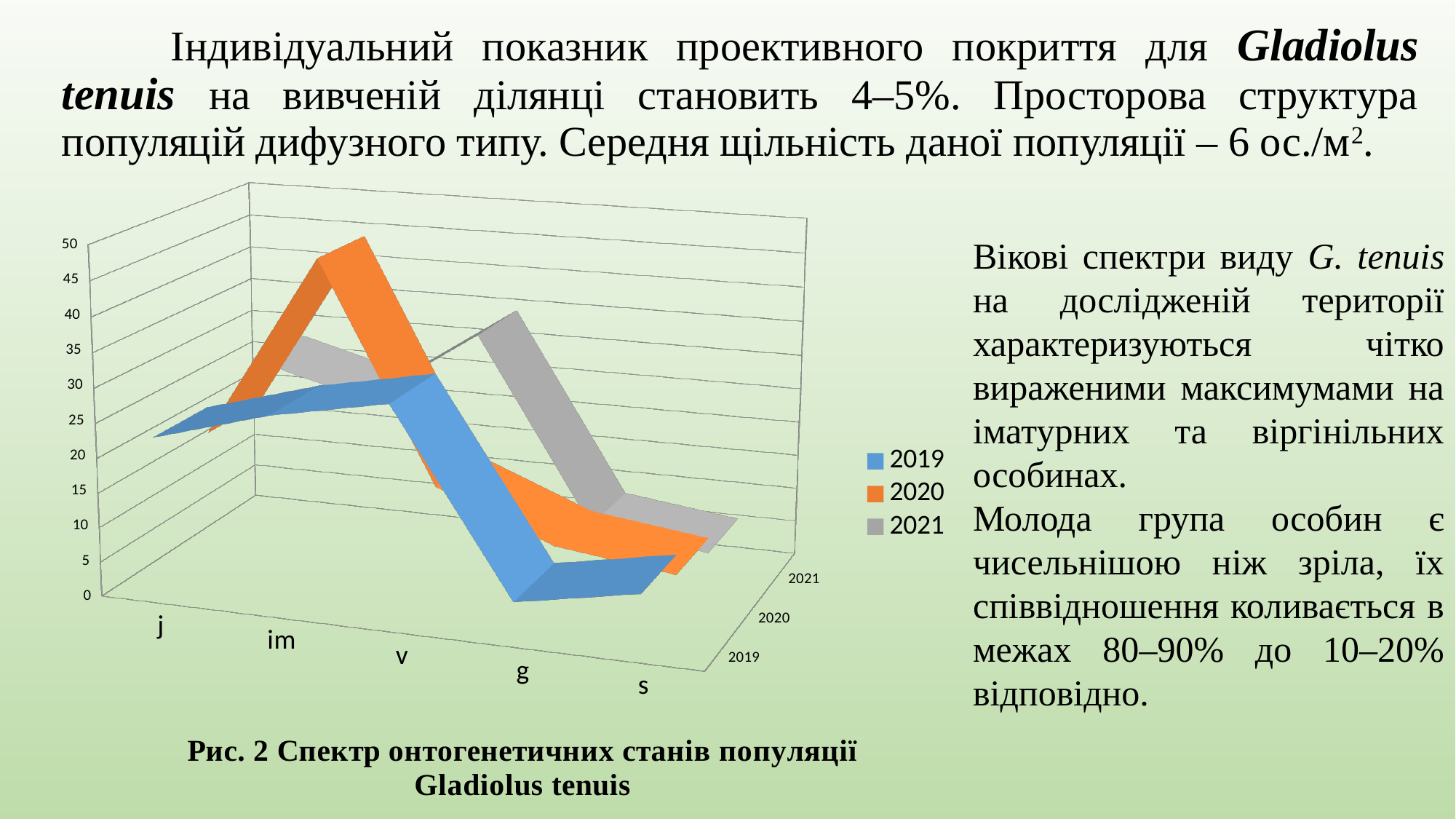
For the 2019 series, which category has the lowest value? g How many series does the chart legend list? 3 Is the value for 2020 at im greater or less than 30? greater At category im, which series has the larger value, 2019 or 2020? 2020 Do the values for the 2019 series rise or fall from v to g? fall Is the value for 2019 at g greater or less than 10? less What is the figure caption below the chart? Рис. 2 Спектр онтогенетичних станів популяції Gladiolus tenuis For the 2019 series, which category has the highest value? v Which years are listed in the chart legend? 2019, 2020, 2021 For the 2020 series, which category has the highest value? im What kind of chart is shown on the slide? line chart How many categories are shown on the x axis of the chart? 5